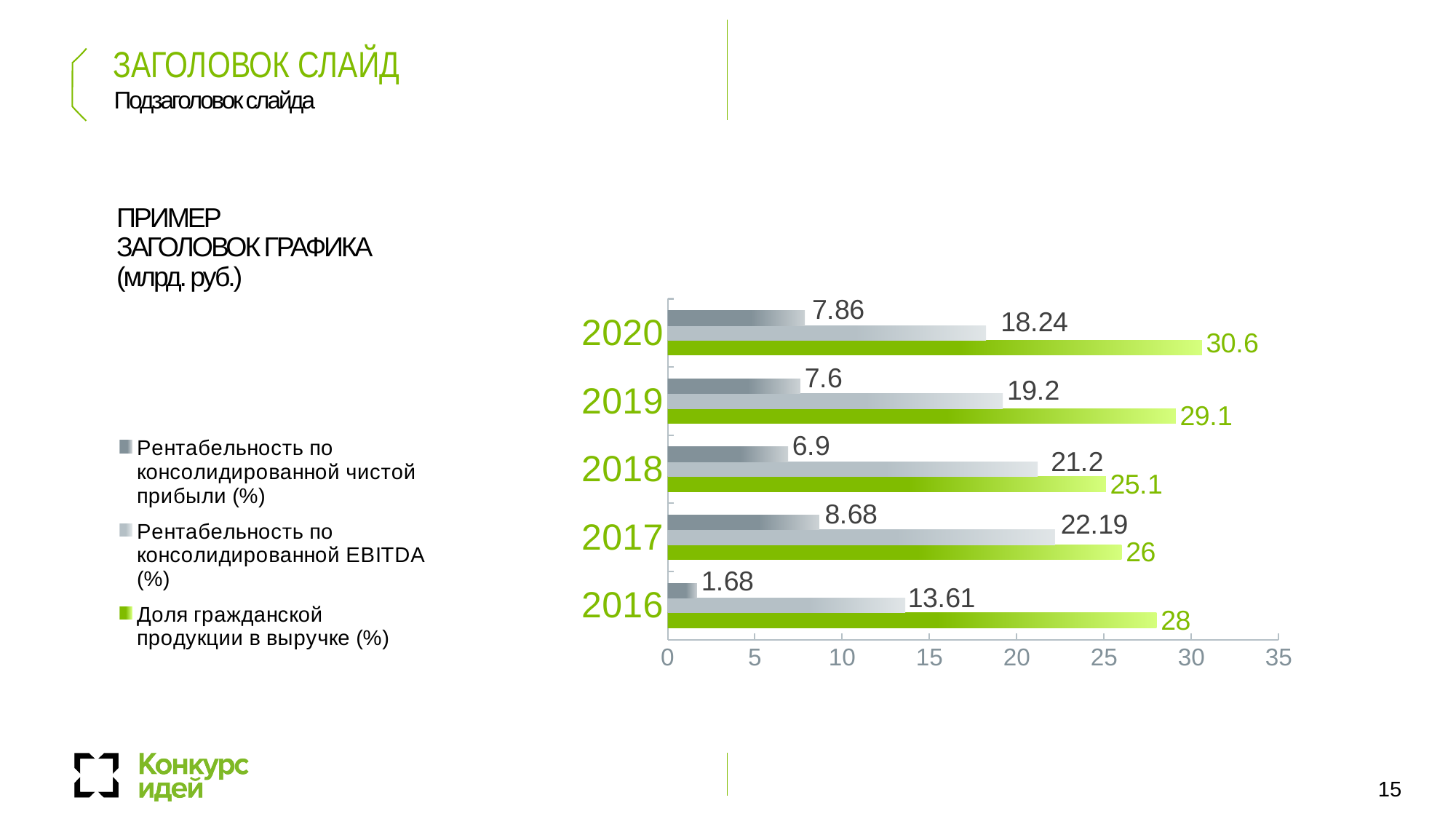
Which is larger: 'Рентабельность по консолидированной EBITDA (%)' in 2019 or in 2016? 2019 Which year has the lowest value for 'Рентабельность по консолидированной чистой прибыли (%)'? 2016 What is the value of 'Рентабельность по консолидированной EBITDA (%)' for 2018? 21.2 Which year has the highest value for 'Рентабельность по консолидированной EBITDA (%)'? 2017 What kind of chart is shown on the slide? Bar chart How many years are shown on the chart? 5 Is the value for 'Доля гражданской продукции в выручке (%)' in 2018 greater or less than 20? greater What is the value of 'Доля гражданской продукции в выручке (%)' for 2020? 30.6 What colour are the bars for 'Доля гражданской продукции в выручке (%)'? Green How many series does the legend list? 3 What is the difference between the 'Доля гражданской продукции в выручке (%)' values for 2020 and 2019? 1.5 What is the value of 'Рентабельность по консолидированной чистой прибыли (%)' for 2016? 1.68